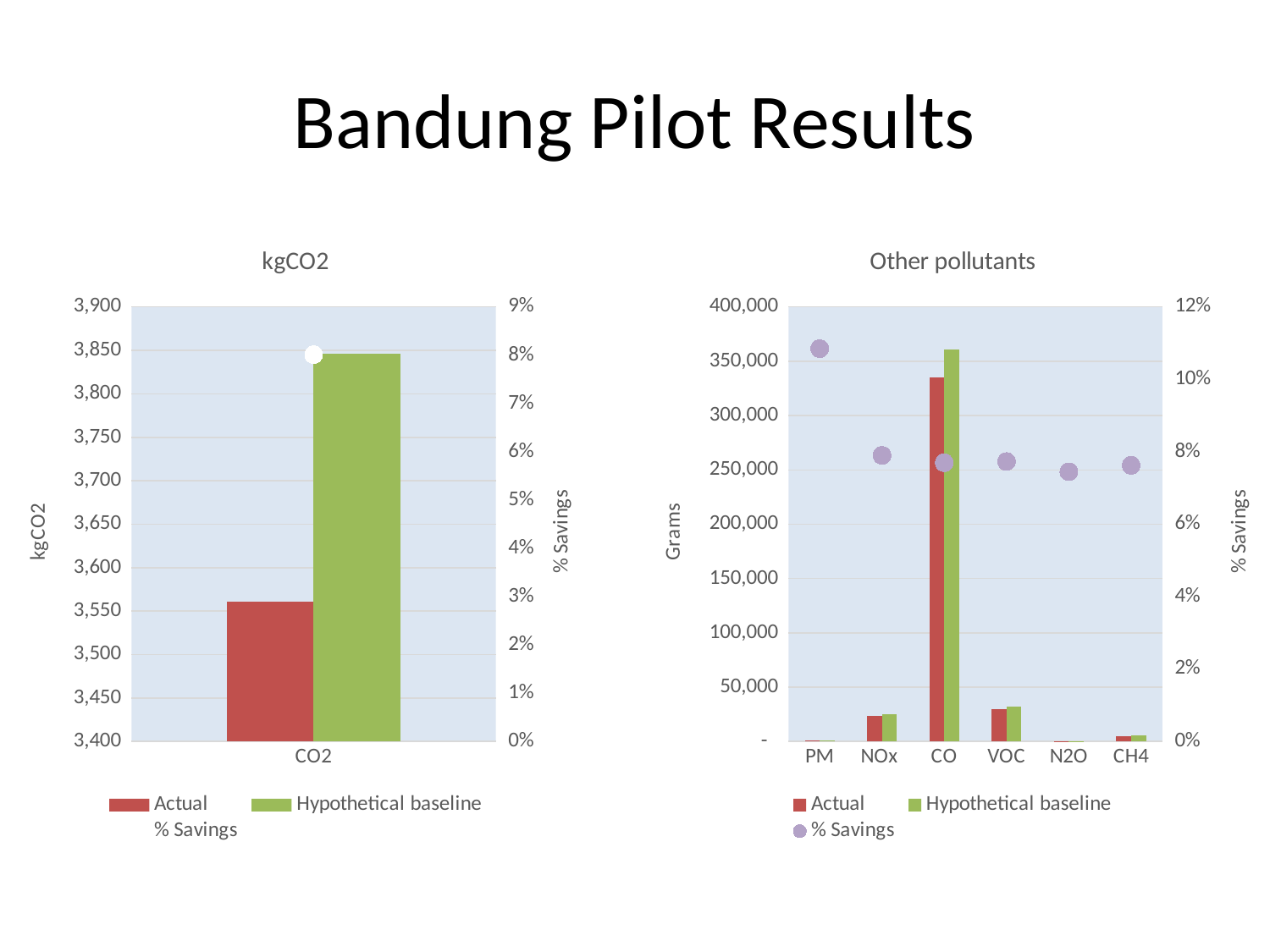
In the Other pollutants chart, is the Hypothetical baseline value for VOC greater or less than 50,000? less In the kgCO2 chart, is the Hypothetical baseline value for CO2 greater or less than 3,800? greater In the Other pollutants chart, is the Actual value for CO greater or less than 300,000? greater How many pollutant categories are shown on the x axis of the Other pollutants chart? 6 What is the label on the left vertical axis of the Other pollutants chart? Grams In the Other pollutants chart, which pollutant has the highest Hypothetical baseline value? CO How many series does the legend of the kgCO2 chart list? 3 In the kgCO2 chart, which is larger for CO2, the Actual value or the Hypothetical baseline? Hypothetical baseline In the kgCO2 chart, what kind of chart is used to show the Actual and Hypothetical baseline values? bar chart In the Other pollutants chart, which pollutant has the highest % Savings? PM